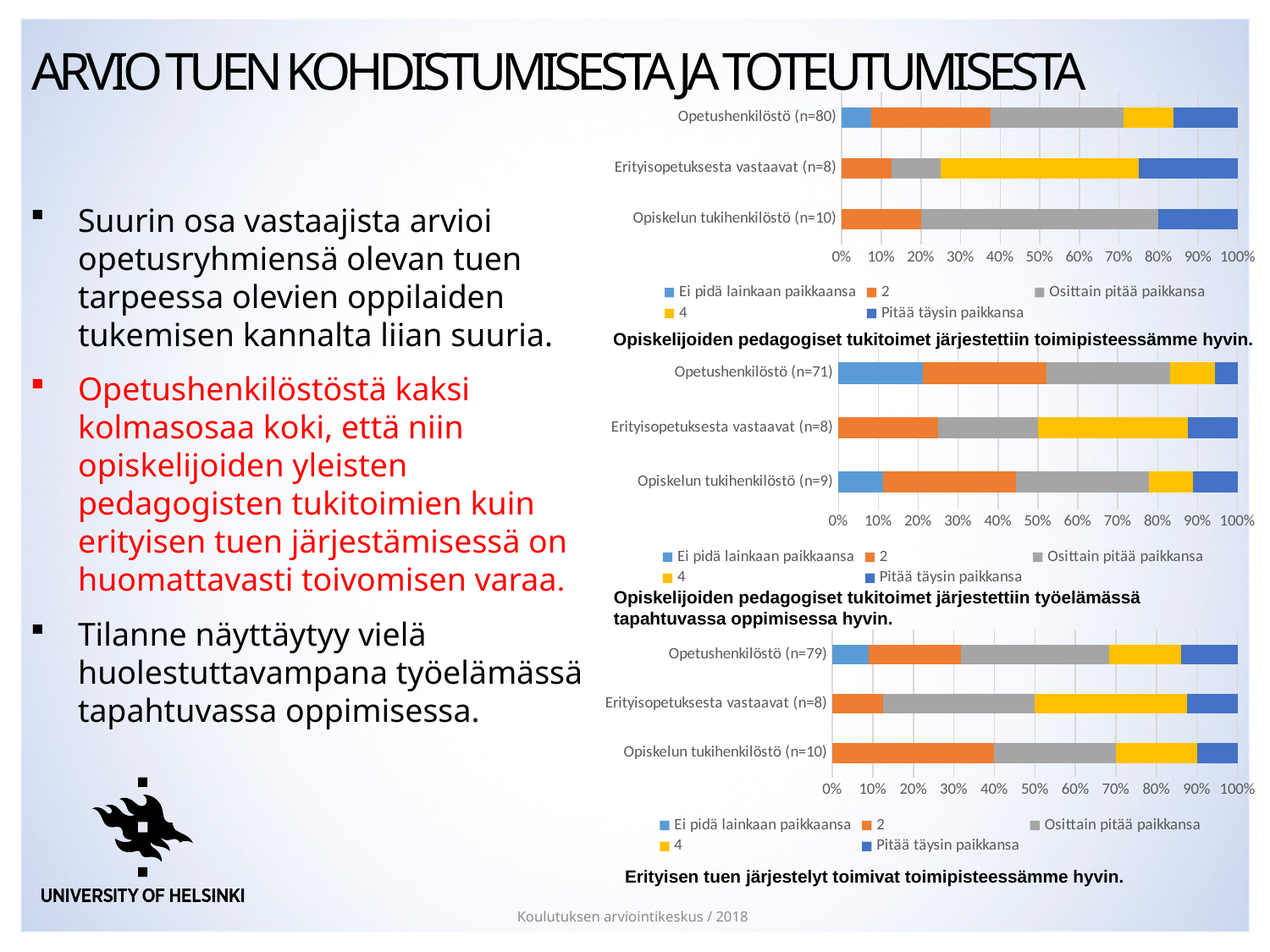
In the middle chart, what is the sample size (n) shown for Opiskelun tukihenkilöstö? n=9 In the middle chart, which respondent group has the largest 'Ei pidä lainkaan paikkaansa' share? Opetushenkilöstö (n=71) In the top chart, what is the sample size (n) shown for Opetushenkilöstö? n=80 How many respondent groups (categories) does the top chart show? 3 In the top chart, is the 'Ei pidä lainkaan paikkaansa' share for Opetushenkilöstö (n=80) greater or less than 10%? less What kind of chart is the top chart on the slide? Stacked bar chart In the middle chart, is the 'Pitää täysin paikkansa' share for Opetushenkilöstö (n=71) greater or less than 10%? less In the top chart, is the 'Osittain pitää paikkansa' share for Opiskelun tukihenkilöstö (n=10) greater or less than 50%? greater Which colour represents 'Pitää täysin paikkansa' in the charts' legends? Dark blue How many series does the legend of the middle chart list? 5 How many charts are shown on the slide? 3